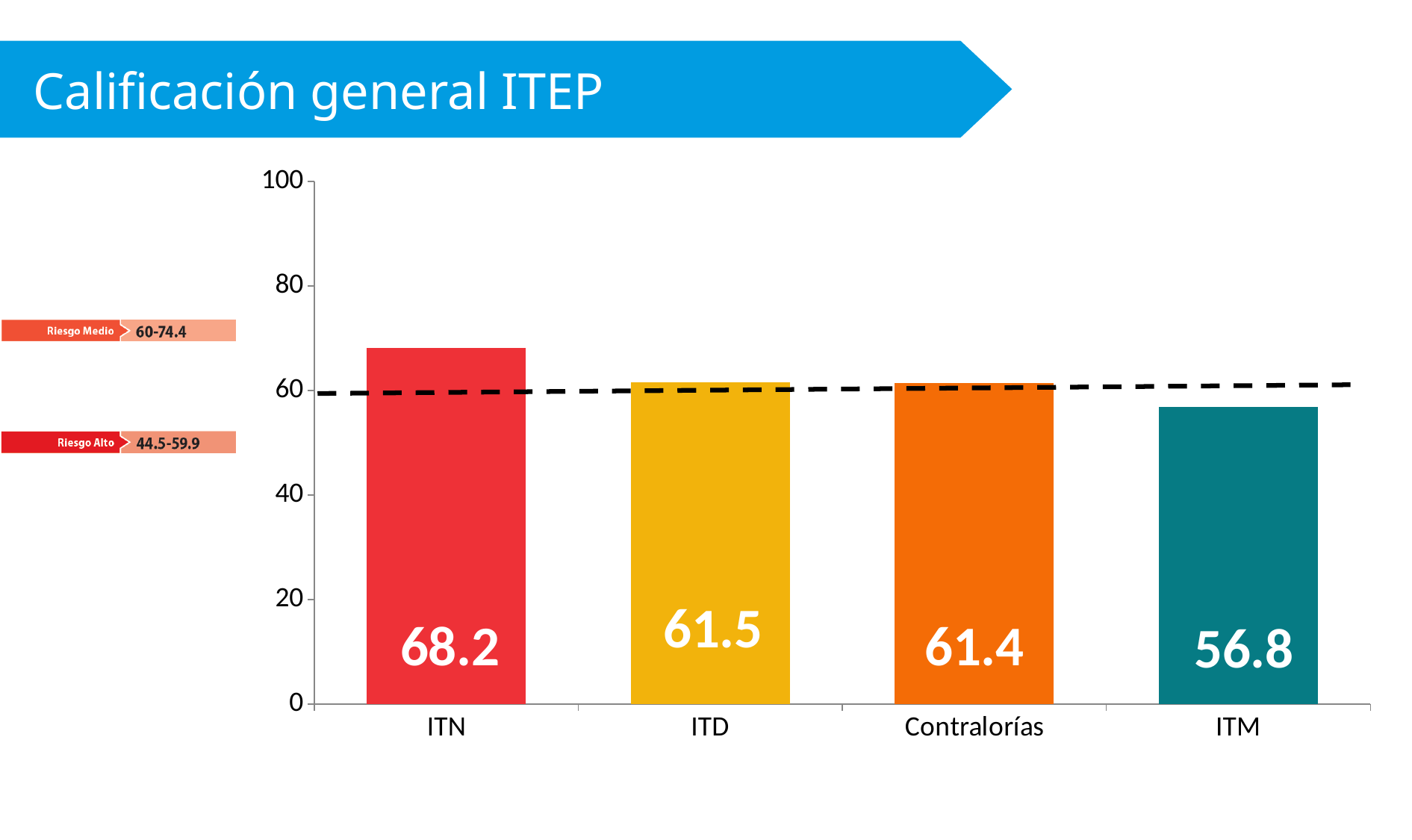
What kind of chart is shown on the slide? bar chart Which category has the highest value? ITN Which is larger, the value for ITN or the value for ITD? ITN Is the value for ITM greater or less than 60? less What is the value for ITD? 61.5 What is the value for Contralorías? 61.4 How many categories are shown on the x axis? 4 What is the difference between the values for ITN and ITM? 11.4 Which category has the lowest value? ITM What is the value for ITM? 56.8 What is the difference between the values for ITD and Contralorías? 0.1 What is the value for ITN? 68.2